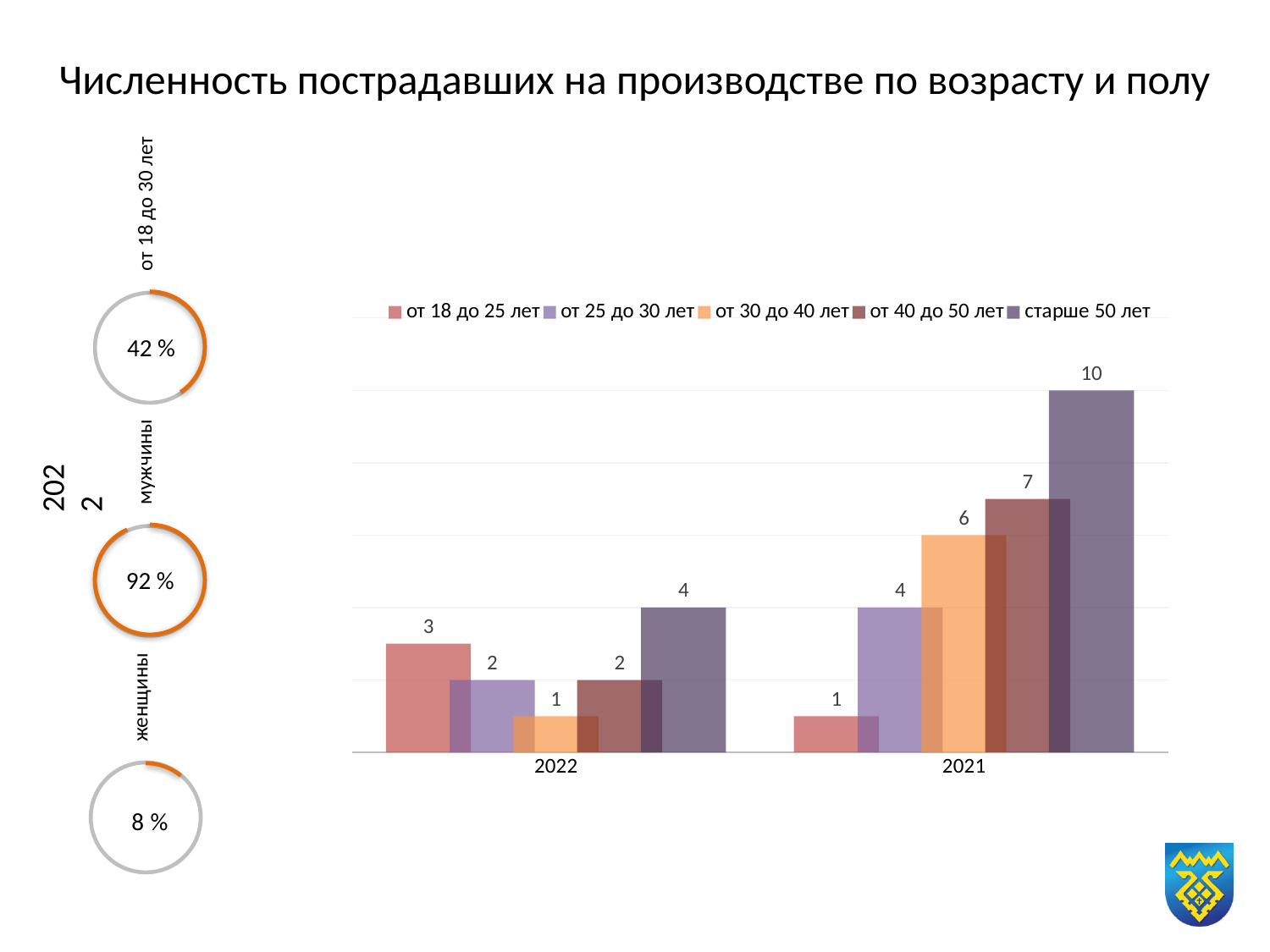
In the bar chart, what is the value for 'от 30 до 40 лет' in 2021? 6 In the bar chart, what is the value for 'старше 50 лет' in 2021? 10 What percentage is shown in the ring chart labelled 'мужчины' on the left of the slide? 92 % How many year categories are shown on the x axis of the bar chart? 2 What kind of chart is the main chart on the right of the slide? bar chart In the bar chart, what is the value for 'от 18 до 25 лет' in 2022? 3 In the bar chart, which is larger: 'от 40 до 50 лет' in 2021 or 'от 40 до 50 лет' in 2022? 2021 How many series does the legend of the bar chart list? 5 In the bar chart, what is the difference between the 'старше 50 лет' values for 2021 and 2022? 6 In the bar chart, which age group has the highest value in 2021? старше 50 лет What percentage is shown in the ring chart labelled 'женщины' on the left of the slide? 8 % In the bar chart, which age group has the lowest value in 2022? от 30 до 40 лет